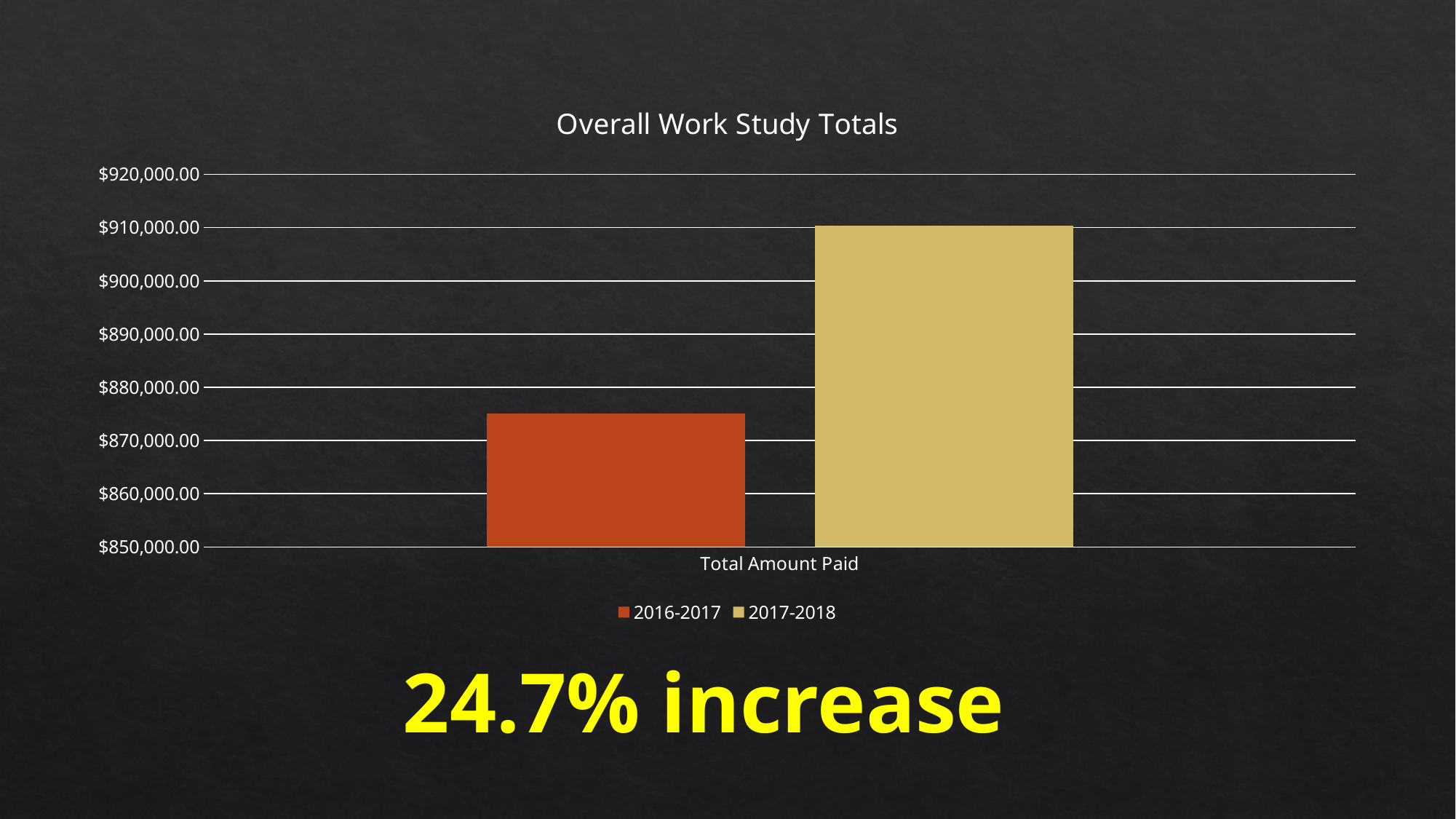
What is the category label on the x axis? Total Amount Paid Which series has the higher value for Total Amount Paid, 2016-2017 or 2017-2018? 2017-2018 Is the value for 2016-2017 greater or less than $870,000.00? greater Is the value for 2017-2018 greater or less than $920,000.00? less What is the title of the chart? Overall Work Study Totals How many categories are shown on the x axis? 1 Which series has the lowest bar? 2016-2017 How many series does the legend list? 2 What kind of chart is shown on the slide? bar chart Is the value for 2016-2017 greater or less than $880,000.00? less Which series has the highest bar? 2017-2018